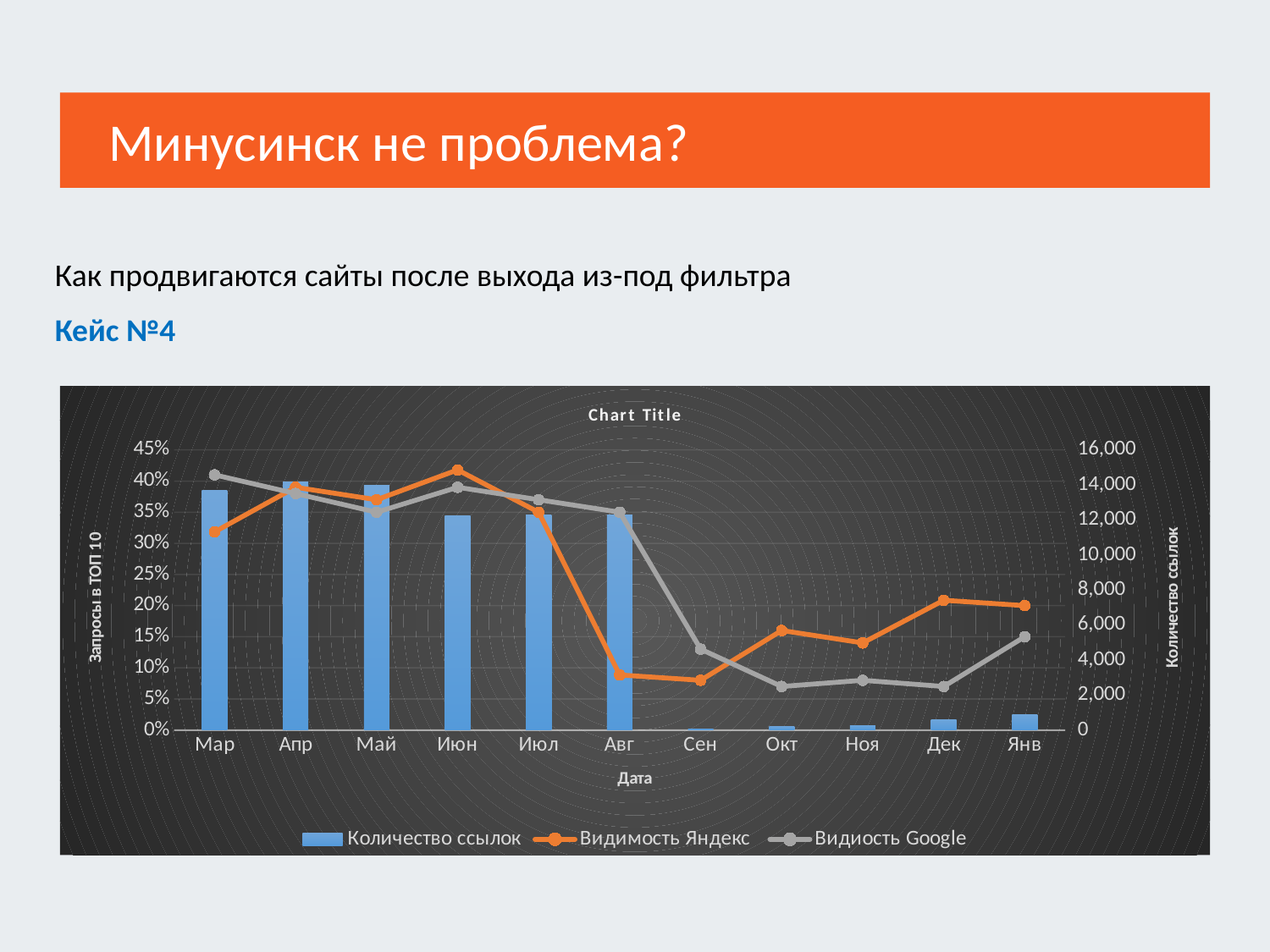
Does the Видиость Google line rise or fall between Авг and Сен? fall How many categories are shown on the x axis of the chart? 11 Is the Видимость Яндекс value for Сен greater or less than 10%? less In which month does the Видиость Google line reach its highest value? Мар In which month does the Видимость Яндекс line reach its highest value? Июн Which is larger: the Видиость Google value for Мар or for Ноя? Мар What is the title of the x axis of the chart? Дата How many series does the chart legend list? 3 Which is larger: the Количество ссылок bar for Мар or for Янв? Мар Is the Видимость Яндекс value for Июн greater or less than 40%? greater What kind of chart is shown on the slide? Combined bar and line chart Is the Видиость Google value for Окт greater or less than 10%? less